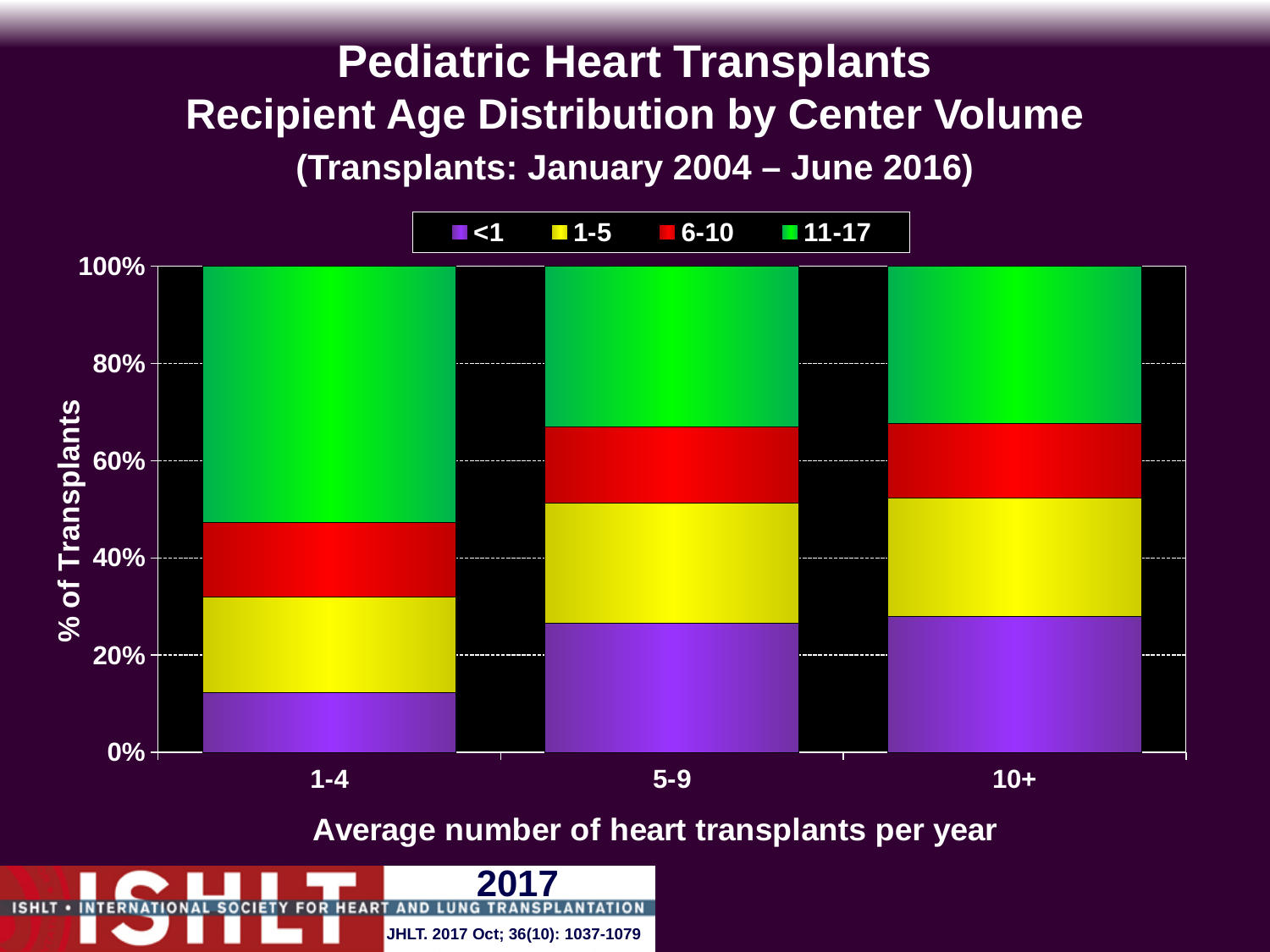
What kind of chart is shown on the slide? stacked bar chart Which category has the smallest share of <1 recipients? 1-4 Is the share of <1 recipients for the 10+ category greater or less than 20%? greater Which category has the largest share of 11-17 recipients? 1-4 Is the share of <1 recipients for the 1-4 category greater or less than 20%? less Is the share of 11-17 recipients for the 1-4 category greater or less than 40%? greater What is the label of the y axis? % of Transplants How many categories are shown on the x axis of the chart? 3 Is the share of <1 recipients larger for the 10+ category or the 1-4 category? 10+ What is the label of the x axis? Average number of heart transplants per year What is the total height of the stacked bar for the 5-9 category? 100% How many series does the legend list? 4